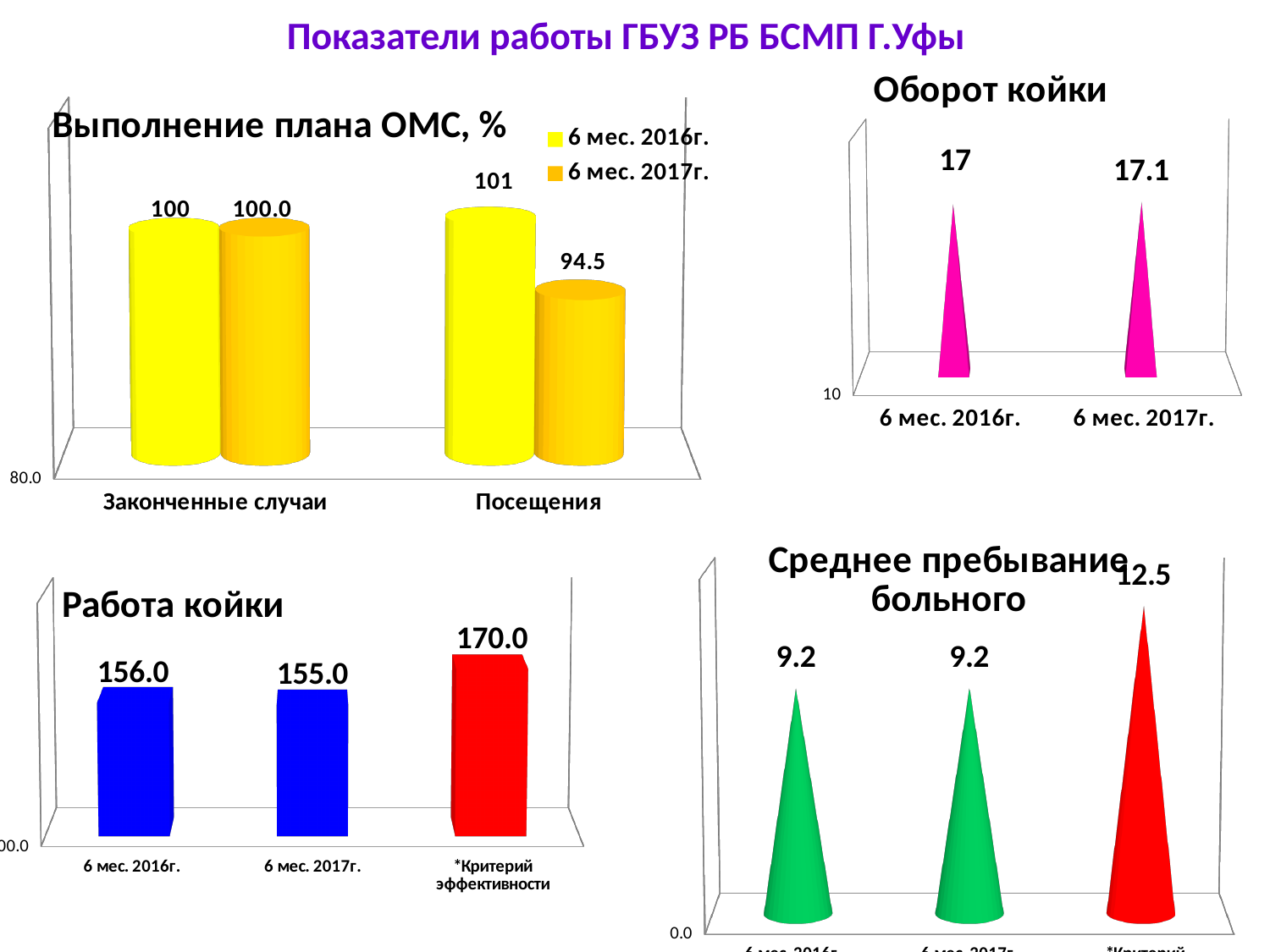
In the chart 'Среднее пребывание больного', what is the value for '6 мес. 2016г.'? 9.2 In the chart 'Выполнение плана ОМС, %', what is the value for 'Посещения' in the series '6 мес. 2016г.'? 101 In the chart 'Работа койки', what is the difference between the values for '6 мес. 2016г.' and '6 мес. 2017г.'? 1.0 In the chart 'Работа койки', which category has the highest value? *Критерий эффективности In the chart 'Работа койки', what is the value for '*Критерий эффективности'? 170.0 In the chart 'Среднее пребывание больного', what is the value of the red cone (third category)? 12.5 In the chart 'Выполнение плана ОМС, %', how many series does the legend list? 2 In the chart 'Выполнение плана ОМС, %', what is the difference between the '6 мес. 2016г.' and '6 мес. 2017г.' values for 'Посещения'? 6.5 In the chart 'Работа койки', what colour is the bar for '*Критерий эффективности'? Red In the chart 'Оборот койки', how many categories are shown? 2 In the chart 'Оборот койки', what is the value for '6 мес. 2017г.'? 17.1 In the chart 'Выполнение плана ОМС, %', what is the value for 'Посещения' in the series '6 мес. 2017г.'? 94.5